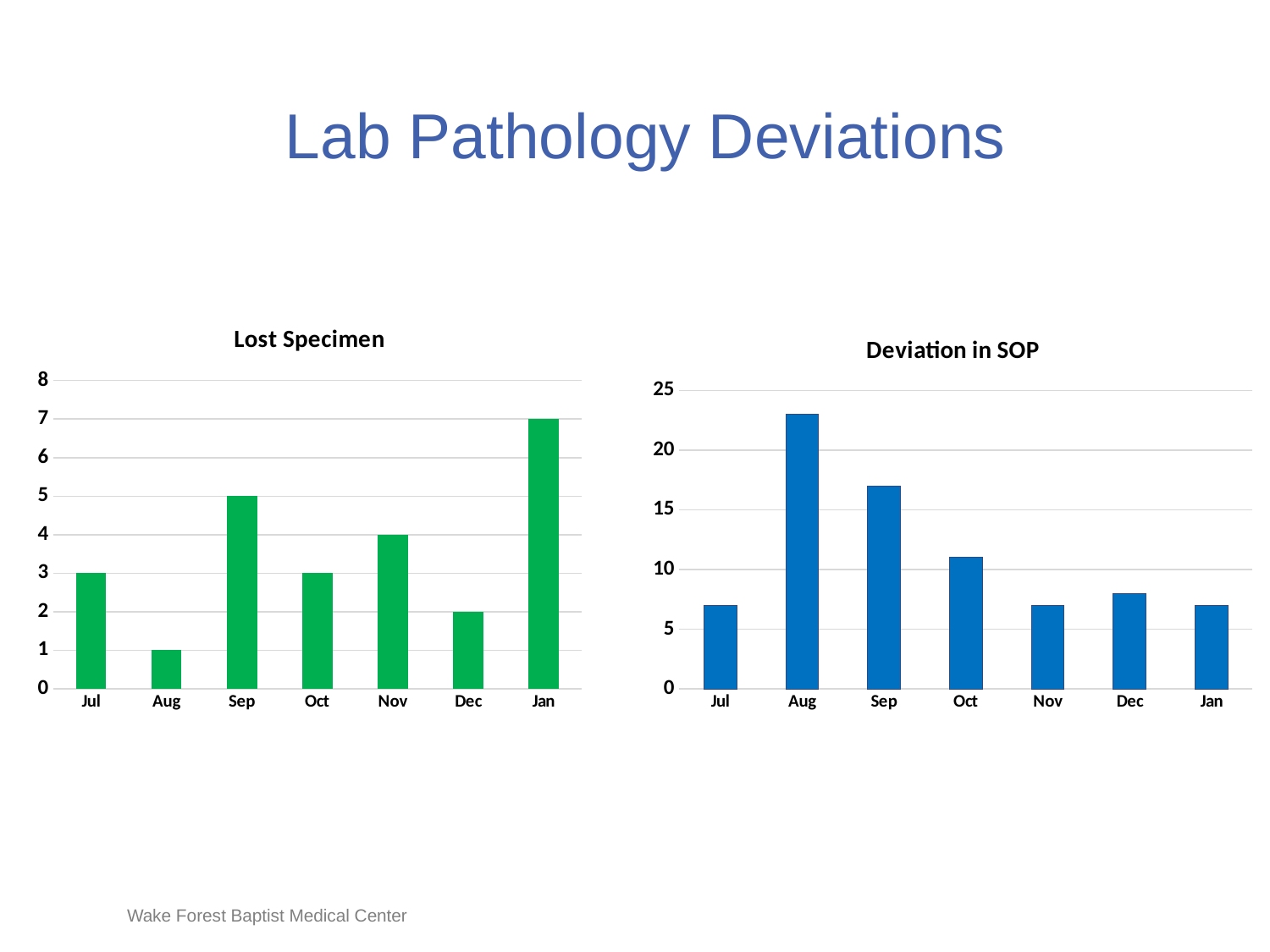
In the Lost Specimen chart, what is the value for Sep? 5 In the Deviation in SOP chart, which month has the highest value? Aug In the Lost Specimen chart, what is the value for Jan? 7 What kind of chart is the Deviation in SOP chart? Bar chart In the Lost Specimen chart, which month has the lowest value? Aug In the Deviation in SOP chart, is the value for Nov greater or less than 10? less In the Deviation in SOP chart, is the value for Aug greater or less than 20? greater In the Deviation in SOP chart, which is larger, the value for Sep or the value for Oct? Sep In the Lost Specimen chart, which is larger, the value for Nov or the value for Dec? Nov In the Lost Specimen chart, which month has the highest value? Jan How many months are shown in the Lost Specimen chart? 7 In the Lost Specimen chart, what is the difference between the values for Jan and Aug? 6